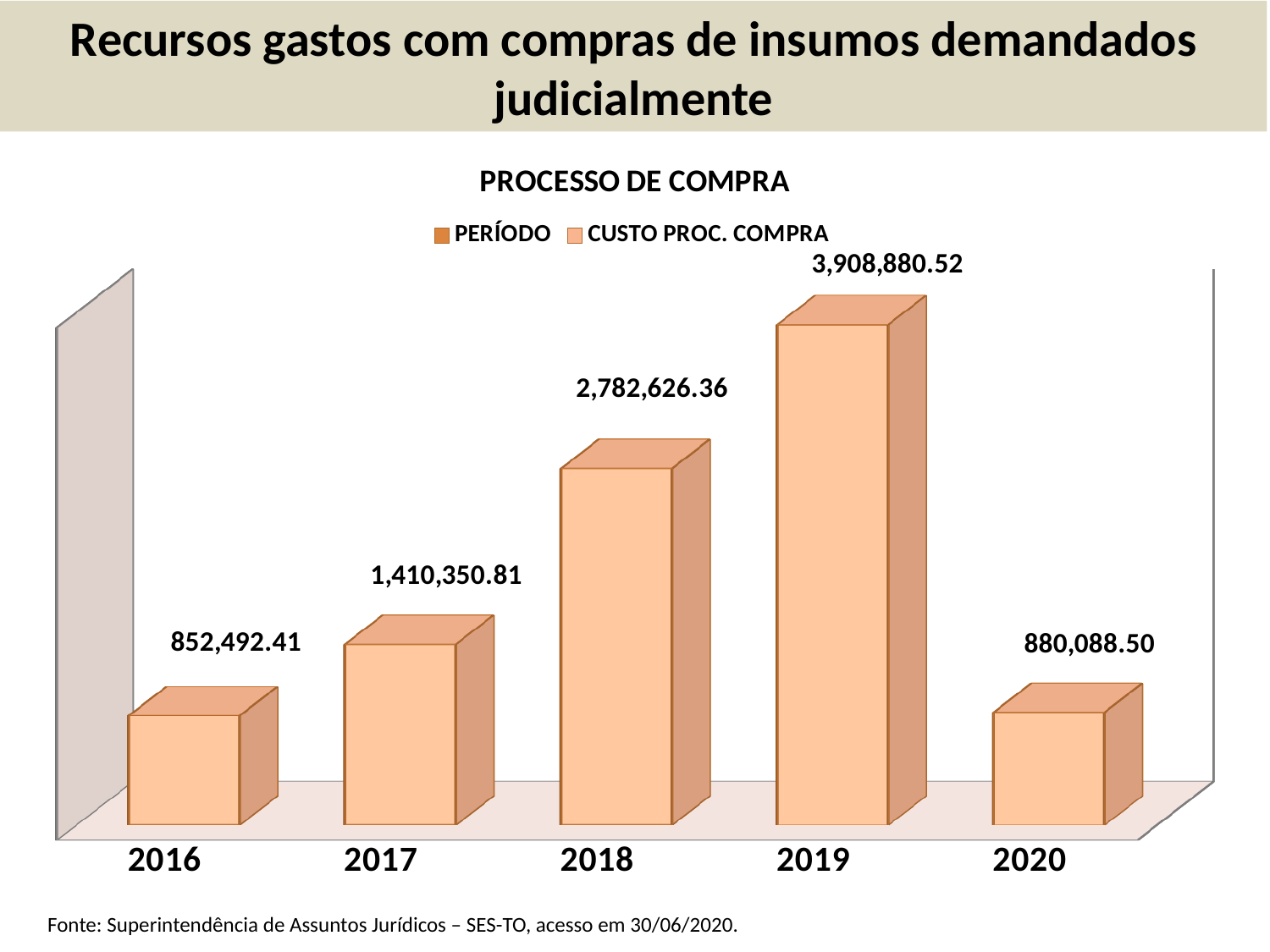
What is the difference between the values for 2019 and 2018 in the PROCESSO DE COMPRA chart? 1,126,254.16 What is the value for 2019 in the PROCESSO DE COMPRA chart? 3,908,880.52 What kind of chart is the PROCESSO DE COMPRA chart? Bar chart How many years are shown on the x axis of the PROCESSO DE COMPRA chart? 5 How many entries does the legend of the PROCESSO DE COMPRA chart list? 2 Which year has the lowest value in the PROCESSO DE COMPRA chart? 2016 What is the value for 2020 in the PROCESSO DE COMPRA chart? 880,088.50 Do the values in the PROCESSO DE COMPRA chart rise or fall from 2016 to 2019? Rise What is the value for 2016 in the PROCESSO DE COMPRA chart? 852,492.41 What is the difference between the values for 2017 and 2016 in the PROCESSO DE COMPRA chart? 557,858.40 Which year has the larger value in the PROCESSO DE COMPRA chart, 2018 or 2017? 2018 Which year has the highest value in the PROCESSO DE COMPRA chart? 2019